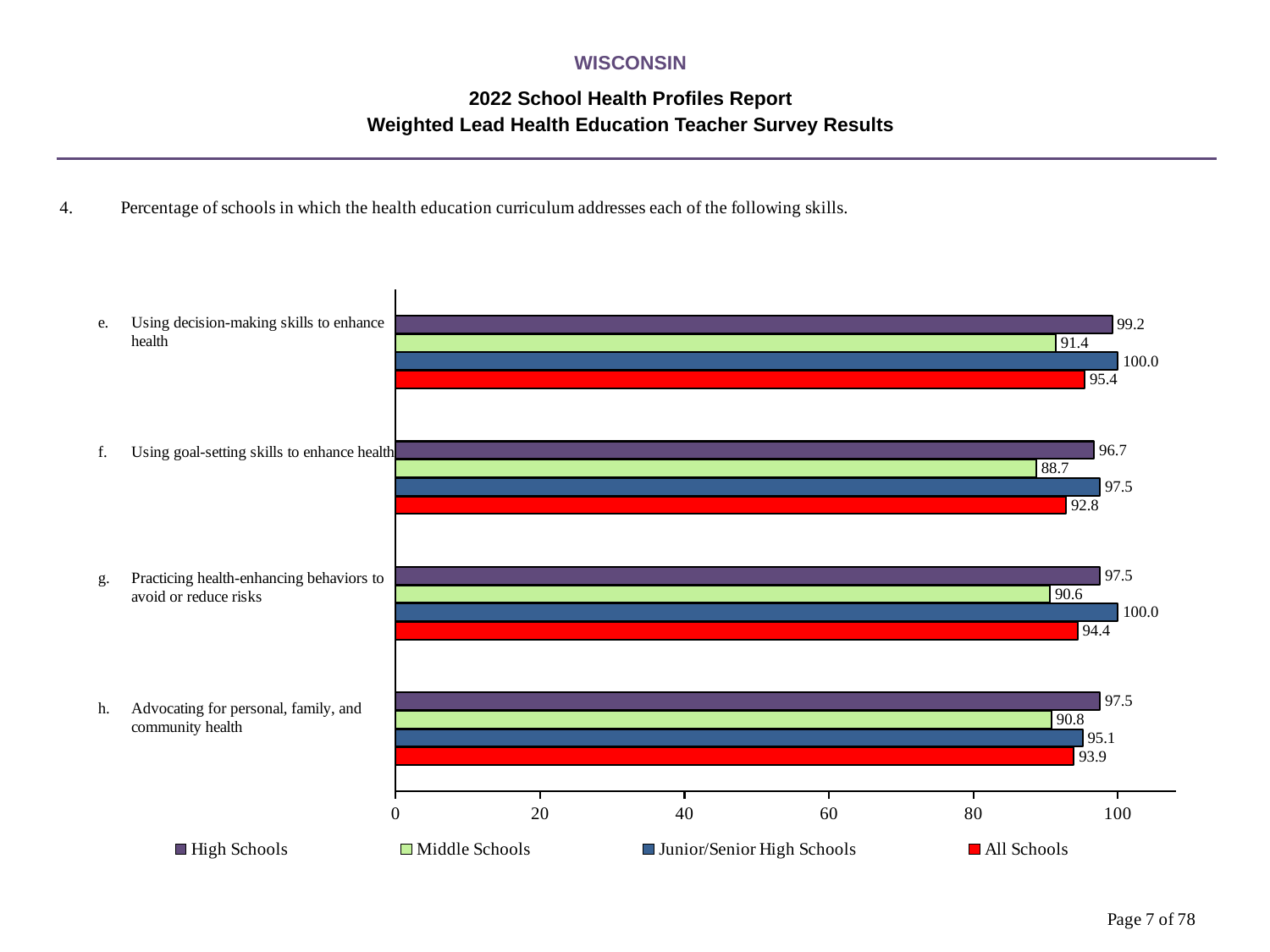
What is the value for Junior/Senior High Schools for 'Practicing health-enhancing behaviors to avoid or reduce risks'? 100.0 What colour represents All Schools in the legend? Red How many skill categories are shown on the chart? 4 What is the value for High Schools for 'Using decision-making skills to enhance health'? 99.2 Which series has the highest value for 'Advocating for personal, family, and community health'? High Schools Which is larger for 'Practicing health-enhancing behaviors to avoid or reduce risks': the High Schools value or the All Schools value? High Schools What is the value for All Schools for 'Advocating for personal, family, and community health'? 93.9 What kind of chart is shown on the slide? Bar chart What is the value for Middle Schools for 'Using goal-setting skills to enhance health'? 88.7 How many series does the legend list? 4 Which series has the lowest value for 'Using decision-making skills to enhance health'? Middle Schools What is the difference between the Junior/Senior High Schools and Middle Schools values for 'Using goal-setting skills to enhance health'? 8.8